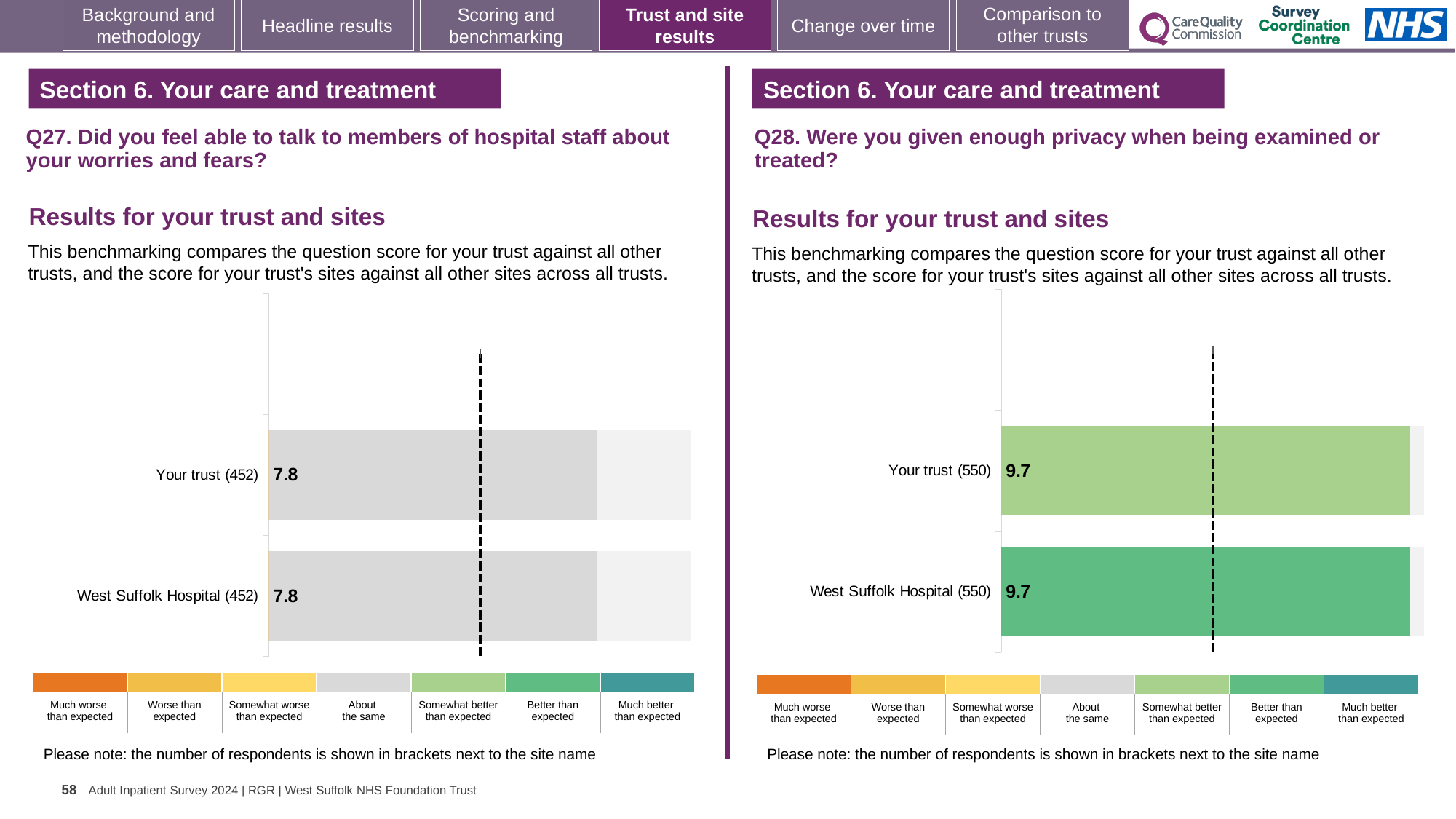
On the Q27 chart (left), which benchmark category does the grey colour of the bars correspond to in the legend? About the same On the Q28 chart (right), which benchmark category does the colour of the West Suffolk Hospital (550) bar correspond to in the legend? Better than expected On the Q28 chart (right), what is the difference between the score for Your trust and the score for West Suffolk Hospital? 0.0 On the Q28 chart (right), what is the score for West Suffolk Hospital (550)? 9.7 On the Q28 chart (right), what is the score for Your trust (550)? 9.7 How many bars are plotted on the Q27 chart (left)? 2 On the Q28 chart (right), how many respondents are shown in brackets for Your trust? 550 On the Q27 chart (left), what is the score for Your trust (452)? 7.8 What kind of chart is used on the Q27 chart (left)? Bar chart On the Q27 chart (left), what is the difference between the score for Your trust and the score for West Suffolk Hospital? 0.0 How many bars are plotted on the Q28 chart (right)? 2 On the Q27 chart (left), what is the score for West Suffolk Hospital (452)? 7.8